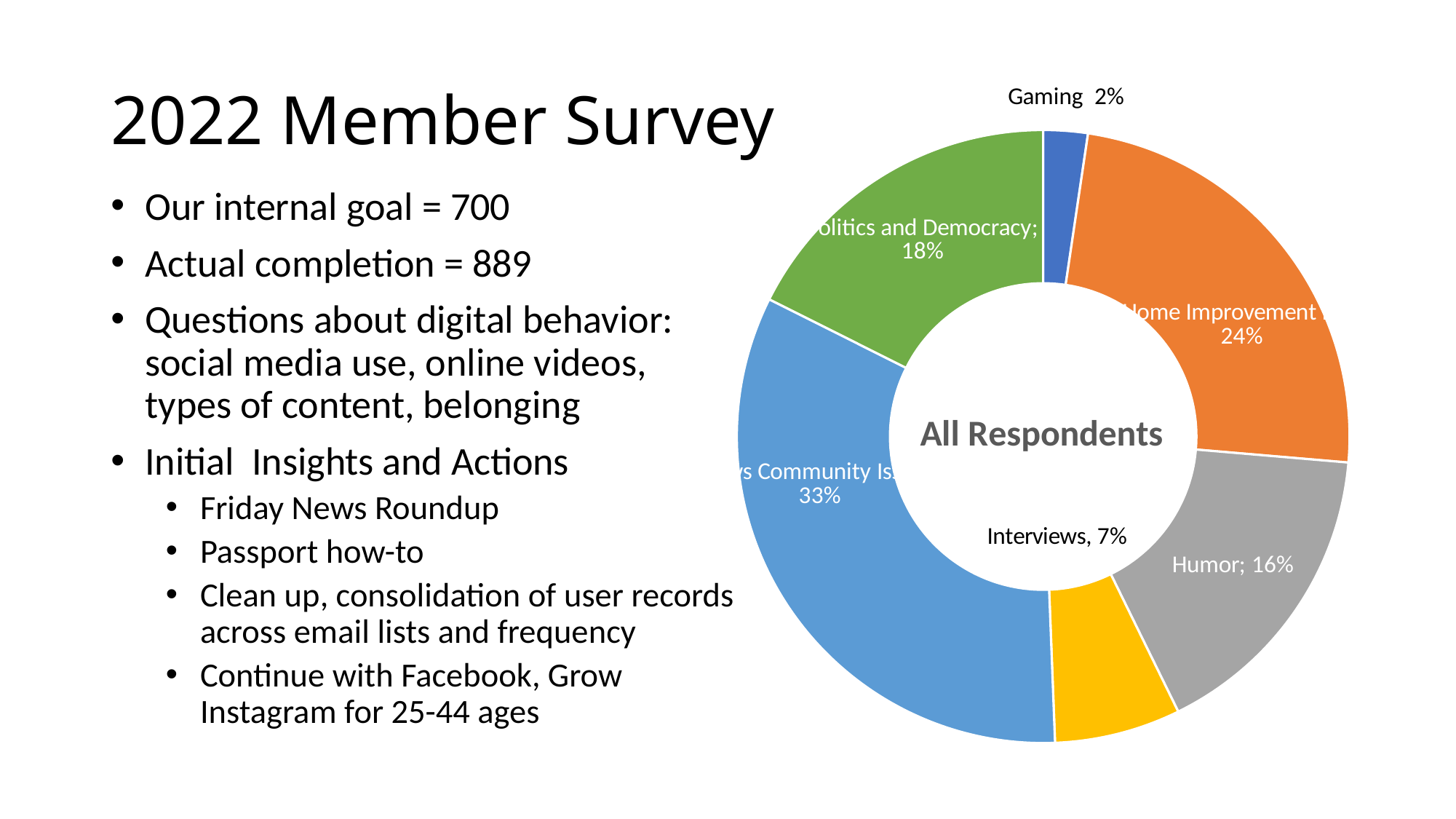
Which category has the smallest share in the chart? Gaming What share of respondents does Humor account for? 16% What kind of chart is shown on the slide? Doughnut (pie) chart How many slices does the chart have? 6 What share of respondents does Interviews account for? 7% What is the largest percentage shown on the chart? 33% Which has a larger share, Home Improvement or Humor? Home Improvement What share of respondents does Gaming account for? 2% What is the difference in percentage points between Home Improvement and Politics and Democracy? 6 percentage points What share of respondents does Politics and Democracy account for? 18% What share of respondents does Home Improvement account for? 24% What is the title shown in the centre of the chart? All Respondents